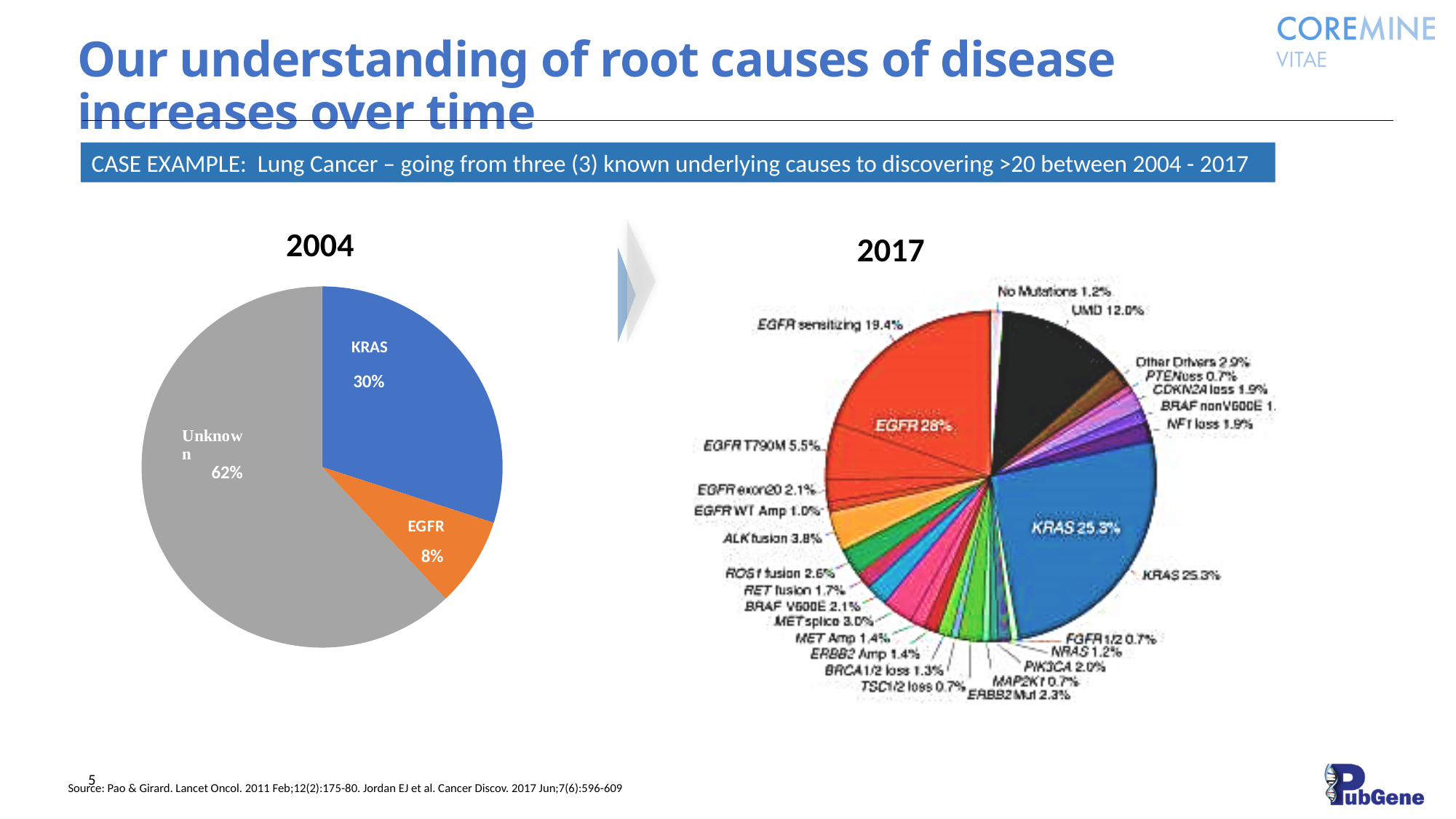
In the 2004 pie chart, what share is labelled for KRAS? 30% What type of chart is the 2004 chart on the left? Pie chart In the 2004 pie chart, what colour is the Unknown slice? Grey In the 2004 pie chart, which is larger, KRAS or EGFR? KRAS In the 2017 pie chart, what share is labelled for EGFR sensitizing? 19.4% How many slices does the 2004 pie chart have? 3 In the 2004 pie chart, which slice is the smallest? EGFR In the 2004 pie chart, what share is labelled for Unknown? 62% In the 2004 pie chart, what share is labelled for EGFR? 8% In the 2004 pie chart, what is the difference between the KRAS share and the EGFR share? 22% In the 2017 pie chart, what share is labelled for KRAS? 25.3% In the 2004 pie chart, which slice is the largest? Unknown